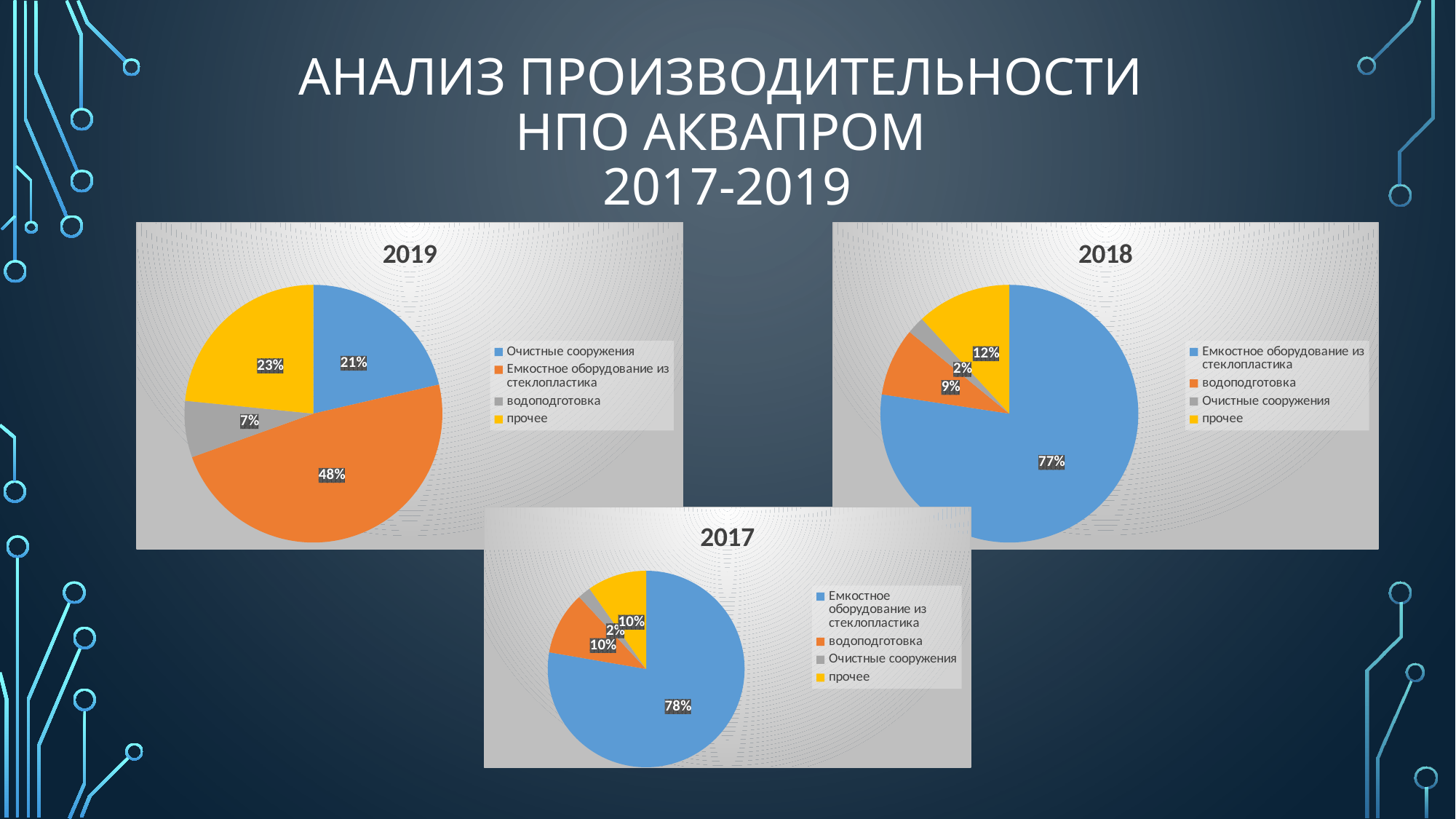
How many categories does the legend of the 2017 chart list? 4 In the 2019 chart, what share does Емкостное оборудование из стеклопластика have? 48% In the 2017 chart, which is larger: водоподготовка or Очистные сооружения? водоподготовка How many charts are shown on the slide? 3 In the 2019 chart, what is the value for Очистные сооружения? 21% In the 2018 chart, which category has the smallest share? Очистные сооружения In the 2018 chart, what is the value for водоподготовка? 9% In the 2019 chart, which category has the smallest share? водоподготовка In the 2018 chart, what share does Емкостное оборудование из стеклопластика have? 77% In the 2019 chart, what is the difference between прочее and водоподготовка? 16% In the 2017 chart, what is the value for Емкостное оборудование из стеклопластика? 78% What kind of chart is the 2018 chart? Pie chart